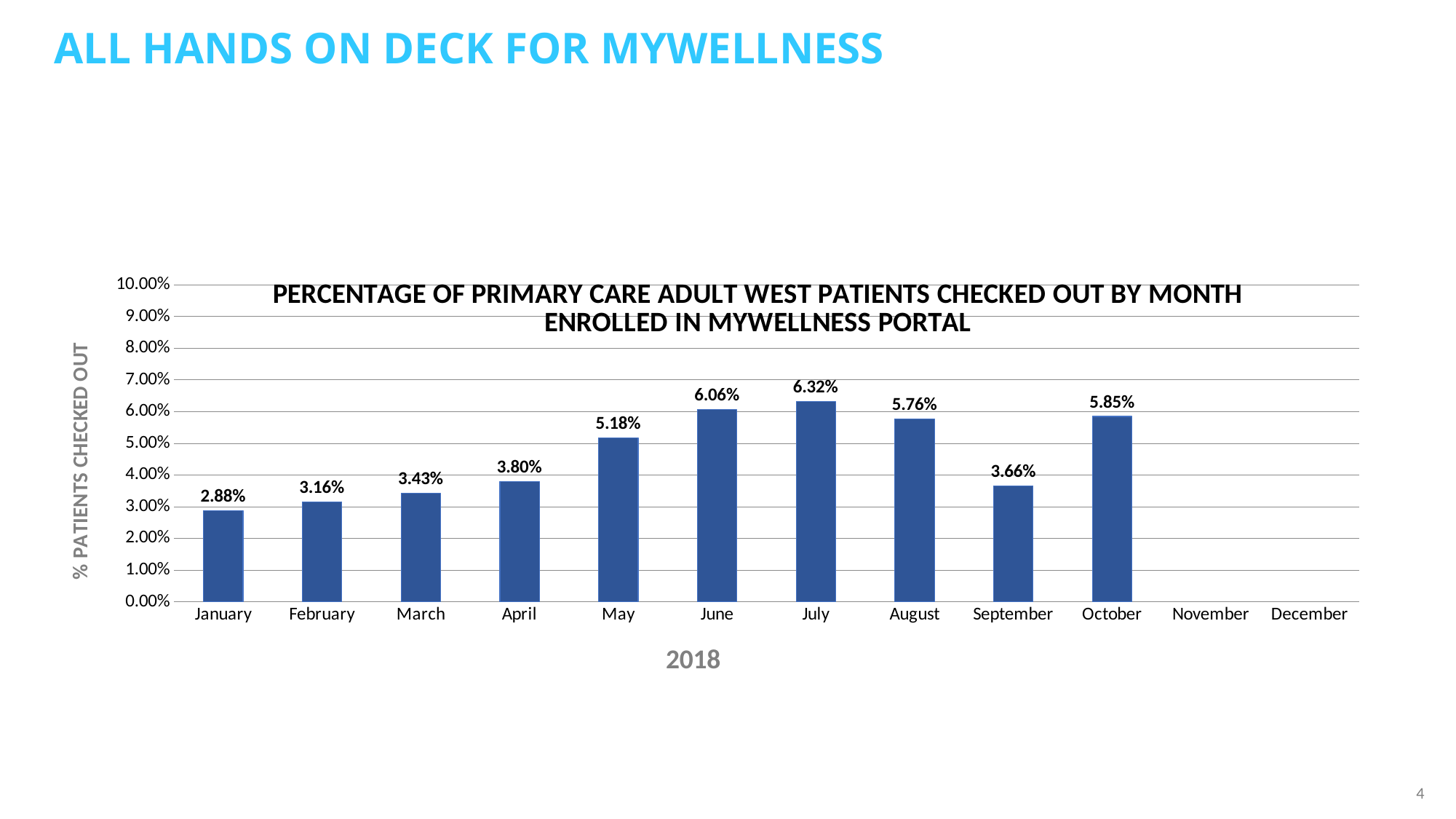
What is the value for September? 3.66% Do the values rise or fall from January to July? rise What kind of chart is shown on the slide? bar chart What is the difference between the values for July and June? 0.26% Is the value for May greater or less than 5.00%? greater What is the value for July? 6.32% Which month has the highest percentage of patients checked out? July Which month with a plotted bar has the lowest percentage? January What is the value for January? 2.88% What is the label on the vertical axis? % PATIENTS CHECKED OUT Which is larger, the value for August or the value for October? October How many months have a bar plotted on the chart? 10